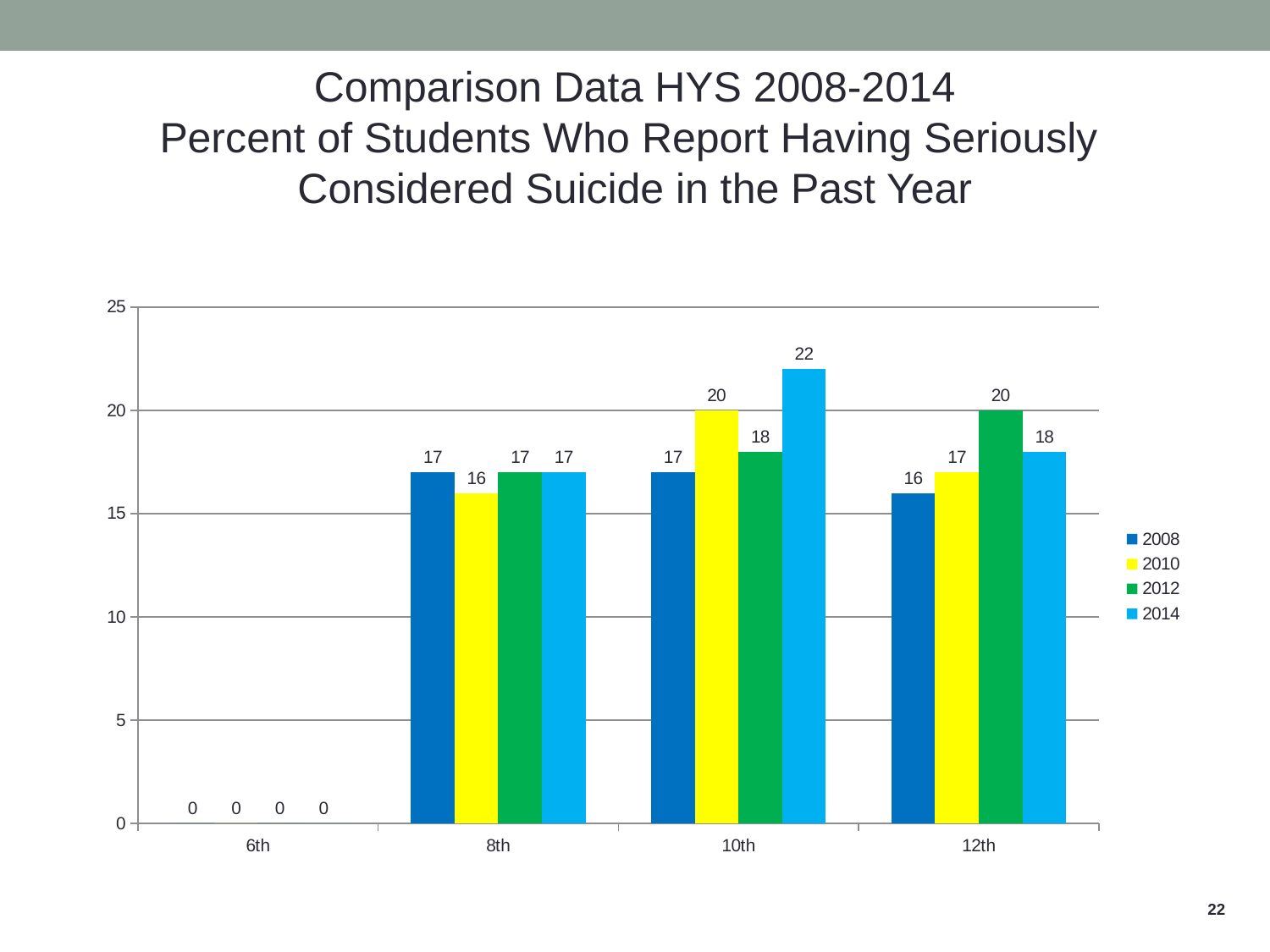
What kind of chart is shown on the slide? bar chart Which colour represents the 2010 series in the legend? yellow What is the value for 12th grade in the 2012 series? 20 Which is larger for 12th grade: the 2012 value or the 2014 value? 2012 Which grade has the highest value in the 2014 series? 10th Do the values for 10th grade rise or fall from 2012 to 2014? rise What is the value for 10th grade in the 2014 series? 22 How many series does the legend list? 4 Which grade has the lowest value in the 2008 series, excluding 6th grade? 12th What is the difference between the 2014 and 2008 values for 10th grade? 5 How many grade categories are shown on the x axis? 4 What is the value for 8th grade in the 2010 series? 16